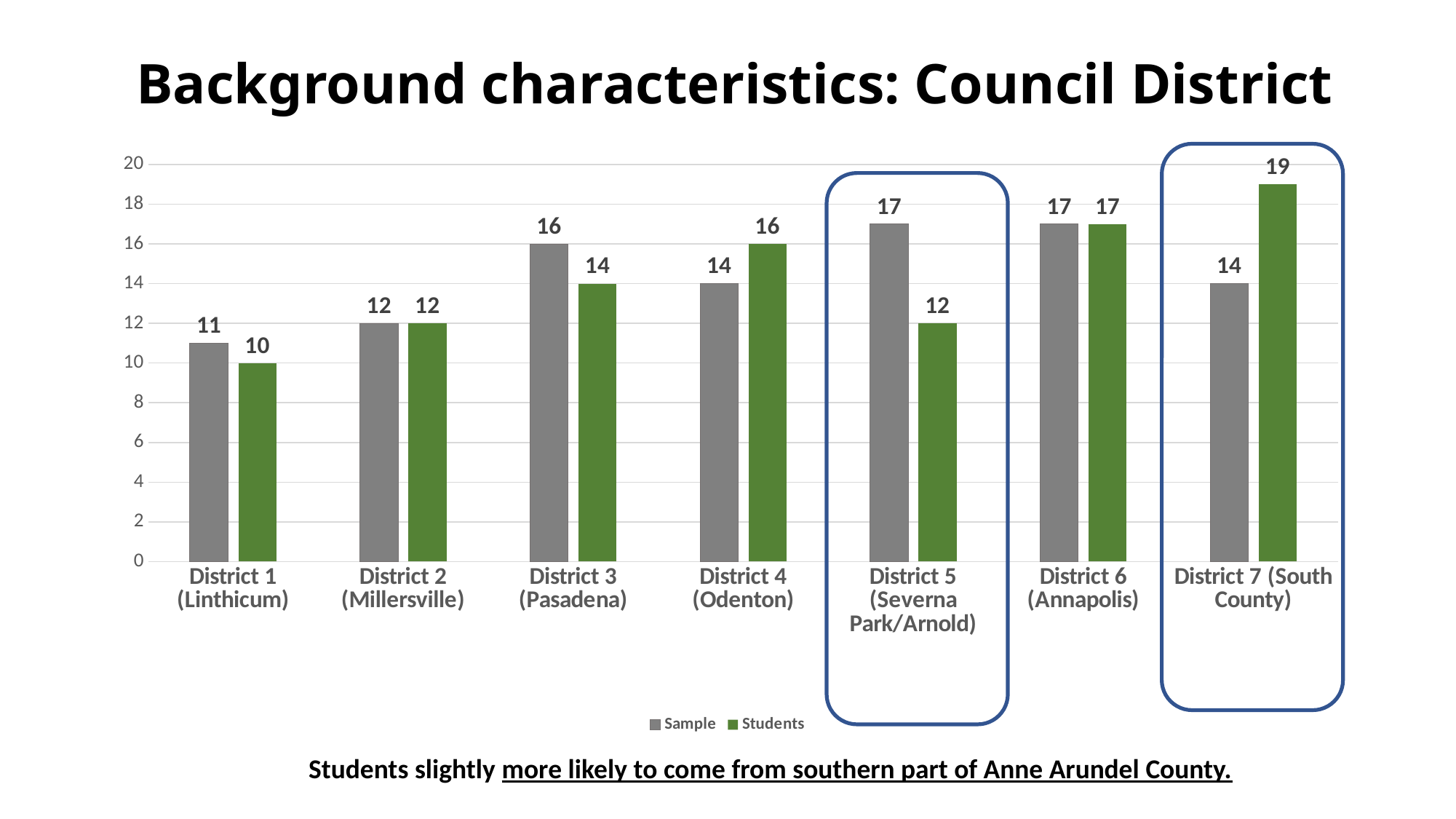
What is the Students value for District 1 (Linthicum)? 10 Which district has the lowest Sample value? District 1 (Linthicum) What is the difference between the Sample and Students values for District 5 (Severna Park/Arnold)? 5 How many series does the legend list? 2 How many districts are shown on the x axis? 7 What is the Students value for District 7 (South County)? 19 Which district has the highest Students value? District 7 (South County) What is the Sample value for District 5 (Severna Park/Arnold)? 17 Which is larger for District 3 (Pasadena): the Sample value or the Students value? Sample What is the difference between the Students and Sample values for District 7 (South County)? 5 Which is larger for District 4 (Odenton): the Sample value or the Students value? Students What kind of chart is shown on the slide? Bar chart